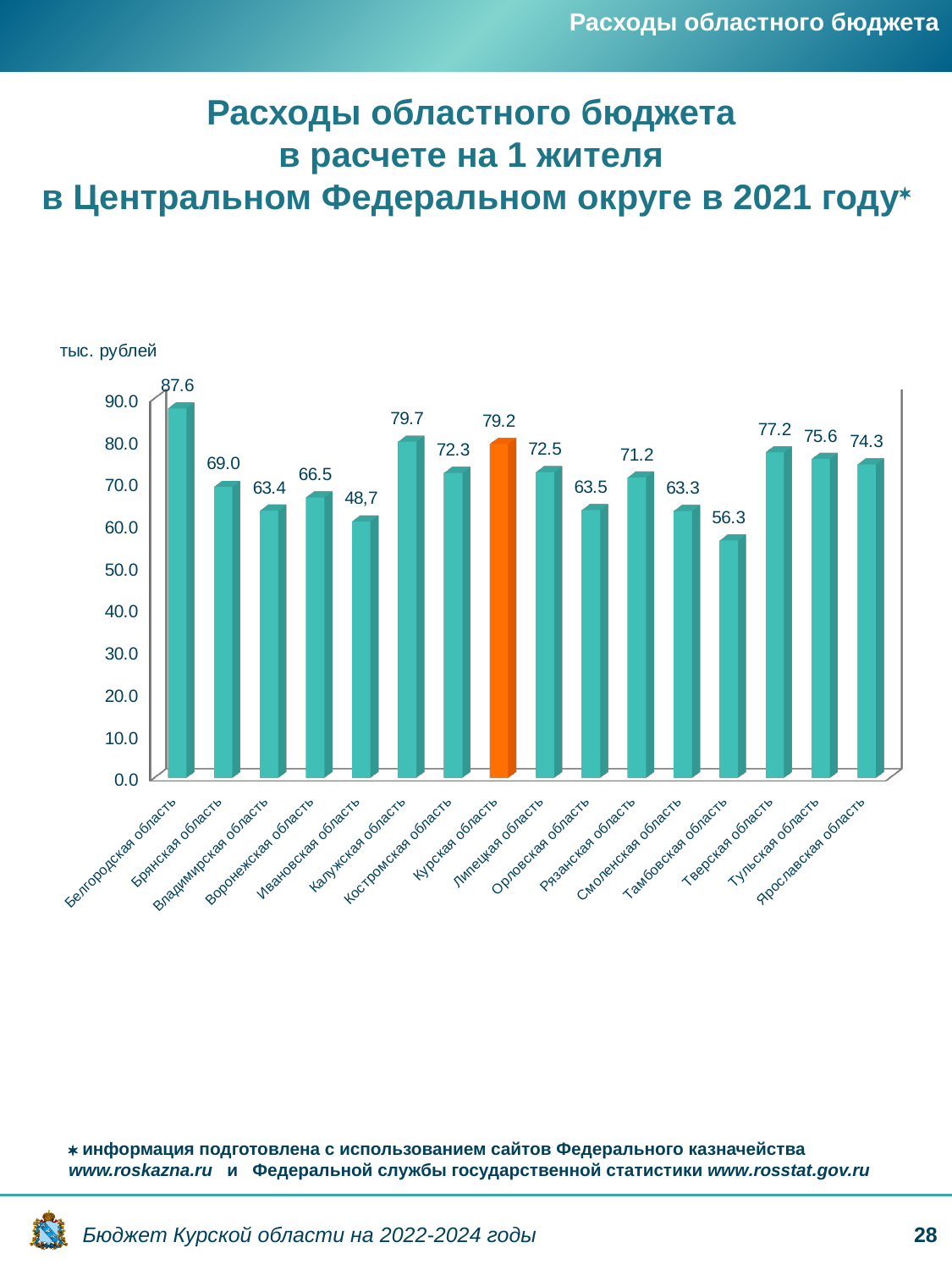
Which is larger, the value for Калужская область or Тверская область? Калужская область What unit is shown above the vertical axis? тыс. рублей What is the difference between the values for Белгородская область and Курская область? 8.4 What is the value for Тамбовская область? 56.3 Which region has the highest value? Белгородская область Which region's bar is highlighted in orange? Курская область How many regions are shown on the chart? 16 What kind of chart is shown on the slide? bar chart What is the value for Курская область? 79.2 Is the value for Тульская область greater or less than 70.0? greater What is the value for Белгородская область? 87.6